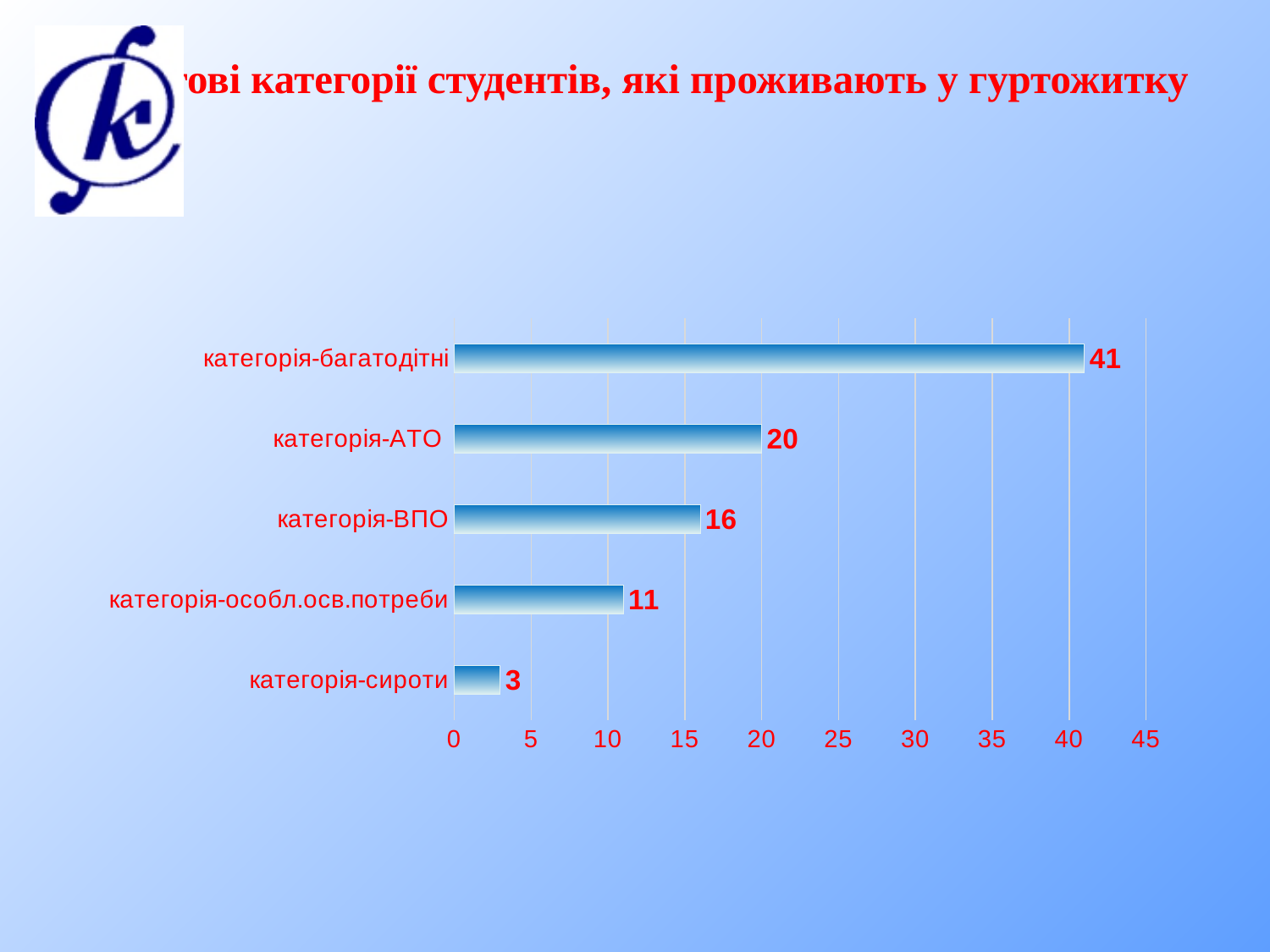
Which category has the lowest value? категорія-сироти What is the value for категорія-особл.осв.потреби? 11 What is the value for категорія-сироти? 3 What is the value for категорія-АТО? 20 What is the value for категорія-багатодітні? 41 What is the highest tick value shown on the horizontal axis? 45 What kind of chart is shown on the slide? bar chart What is the value for категорія-ВПО? 16 What is the difference between the values for категорія-багатодітні and категорія-АТО? 21 How many categories are shown in the chart? 5 Which is larger, the value for категорія-ВПО or the value for категорія-особл.осв.потреби? категорія-ВПО Which category has the highest value? категорія-багатодітні